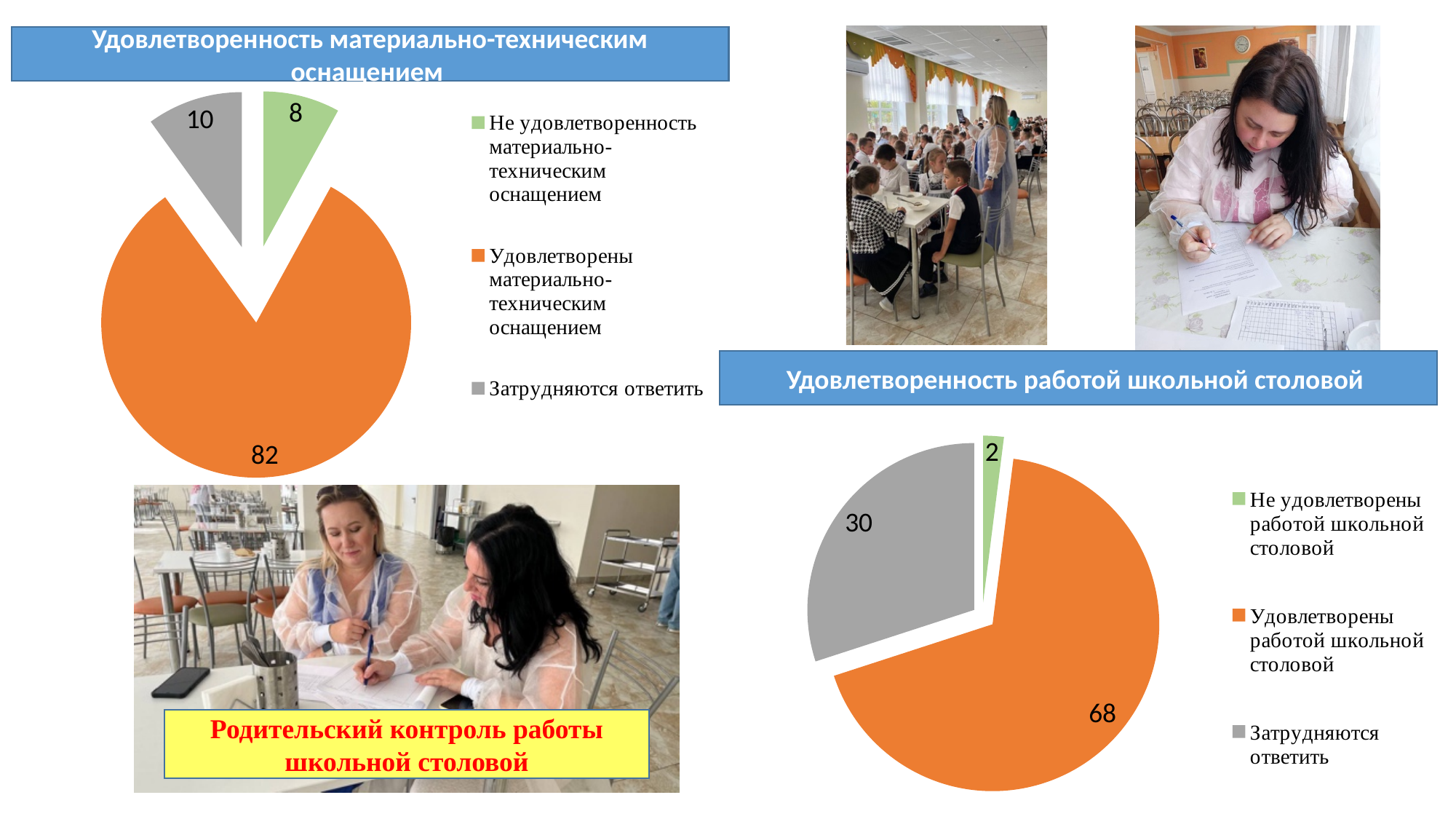
In the chart titled "Удовлетворенность работой школьной столовой", which category has the largest slice? Удовлетворены работой школьной столовой In the chart titled "Удовлетворенность материально-техническим оснащением", what is the value for "Затрудняются ответить"? 10 In the chart titled "Удовлетворенность работой школьной столовой", what is the value for "Не удовлетворены работой школьной столовой"? 2 In the chart titled "Удовлетворенность материально-техническим оснащением", what is the difference between the values for "Удовлетворены" and "Затрудняются ответить"? 72 In the chart titled "Удовлетворенность работой школьной столовой", which is larger: "Затрудняются ответить" or "Не удовлетворены работой школьной столовой"? Затрудняются ответить In the chart titled "Удовлетворенность материально-техническим оснащением", what is the value for "Удовлетворены материально-техническим оснащением"? 82 In the chart titled "Удовлетворенность работой школьной столовой", what is the value for "Затрудняются ответить"? 30 In the chart titled "Удовлетворенность материально-техническим оснащением", how many slices does the pie have? 3 In the chart titled "Удовлетворенность материально-техническим оснащением", which category has the smallest slice? Не удовлетворенность материально-техническим оснащением In the chart titled "Удовлетворенность работой школьной столовой", what share of the pie does "Удовлетворены работой школьной столовой" represent? 68% What type of chart is used for "Удовлетворенность работой школьной столовой"? Pie chart In the chart titled "Удовлетворенность материально-техническим оснащением", what colour is the slice for "Удовлетворены материально-техническим оснащением"? Orange